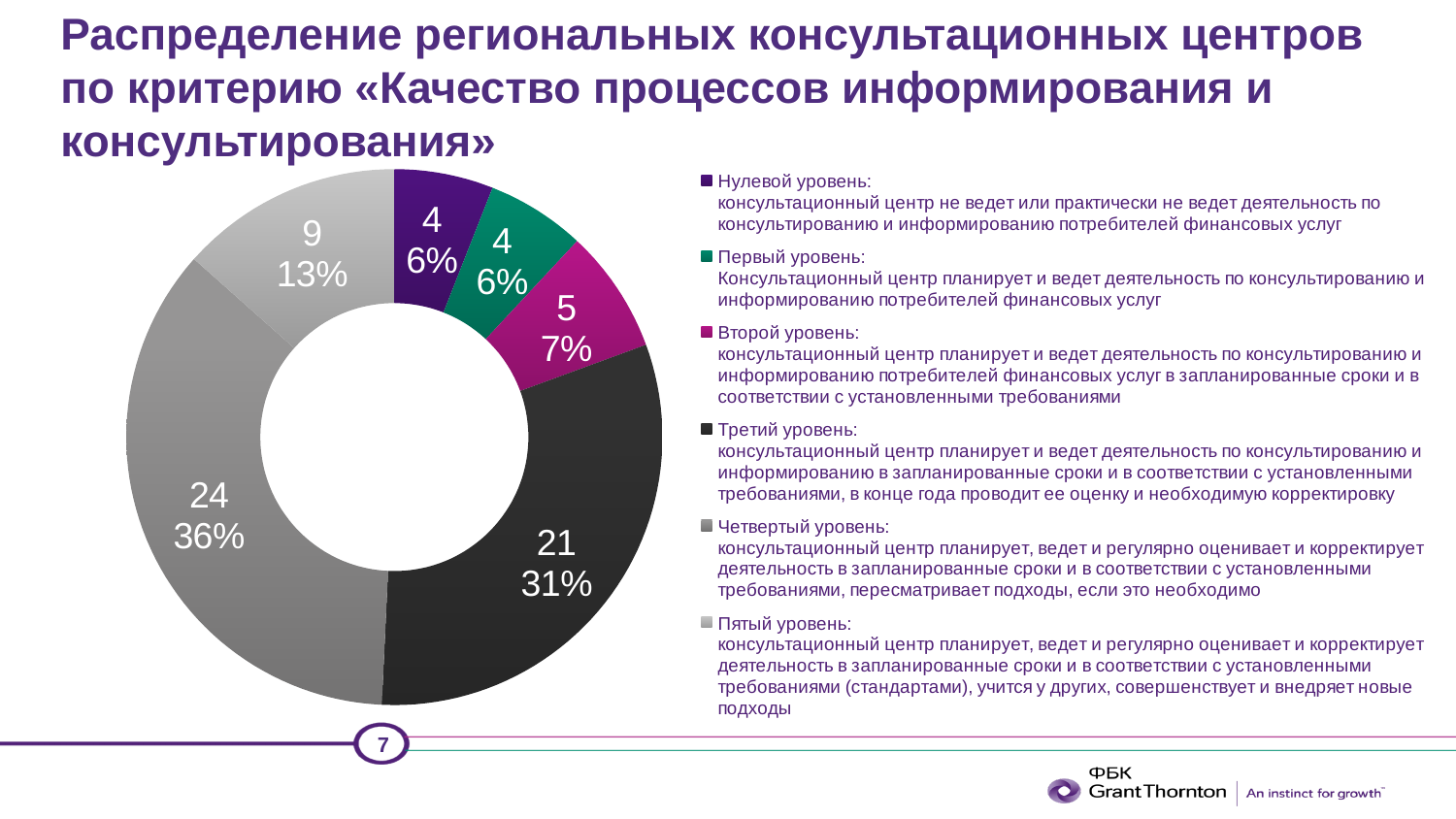
What type of chart is shown on the slide? Donut (pie) chart Which colour represents the Второй уровень in the chart? Magenta (purple-pink) Which level has the largest number of consulting centres? Четвертый уровень How many consulting centres are at the Четвертый уровень (fourth level)? 24 Which has more consulting centres: the Пятый уровень or the Второй уровень? Пятый уровень How many consulting centres are at the Второй уровень (second level)? 5 What percentage share do the Нулевой уровень and Первый уровень segments each have? 6% What is the percentage share of the Пятый уровень (fifth level) segment? 13% What percentage share does the Третий уровень (third level) segment have? 31% How many categories (levels) does the chart show? 6 What is the total number of consulting centres across all segments of the chart? 67 What is the difference in the number of centres between the Четвертый уровень and the Третий уровень? 3